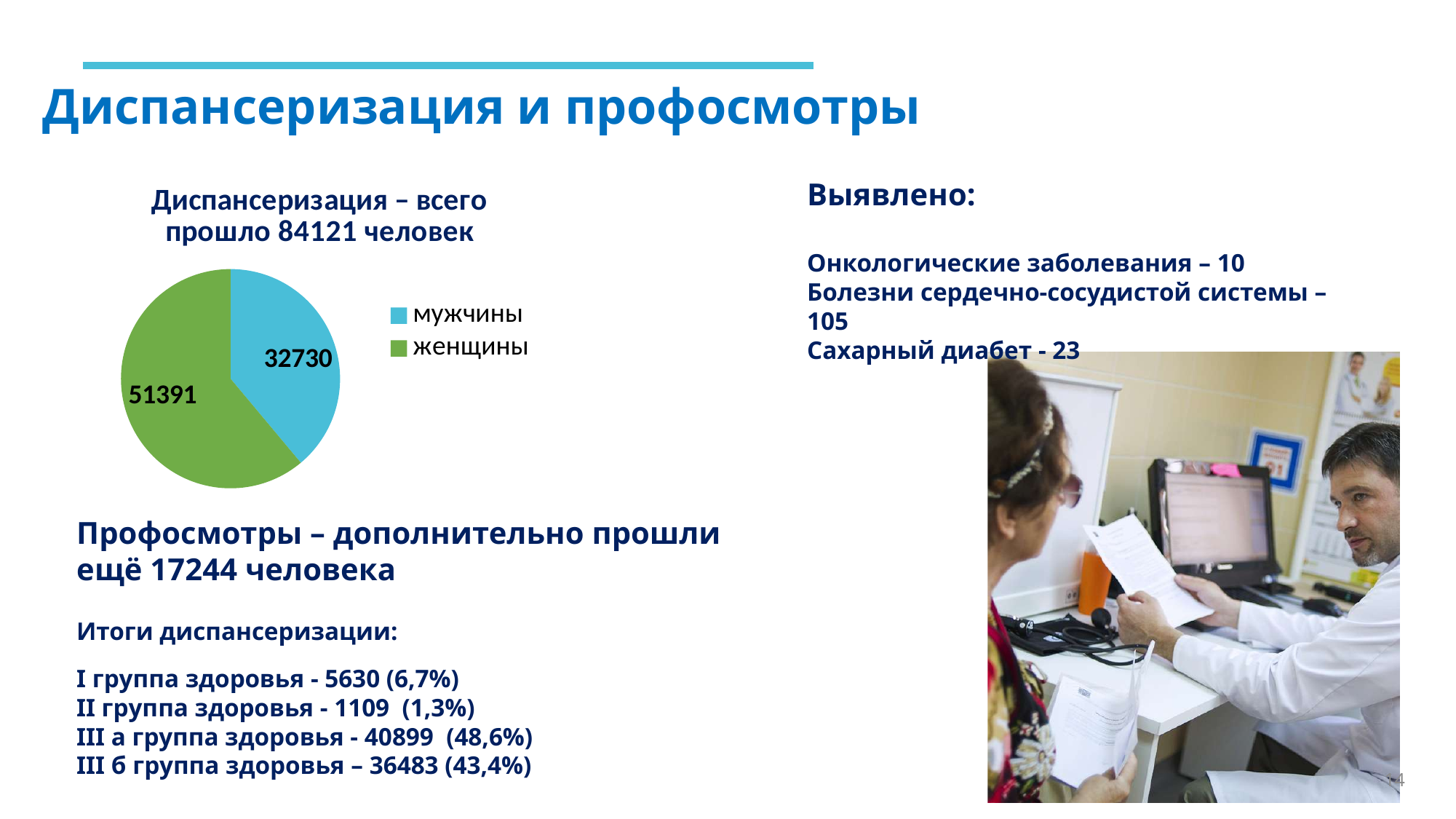
How many entries does the legend of the pie chart list? 2 What colour is the slice for женщины in the pie chart? green What is the value for мужчины in the pie chart? 32730 What is the total of the two slices in the pie chart? 84121 What is the difference between the values for женщины and мужчины in the pie chart? 18661 What is the title of the pie chart? Диспансеризация – всего прошло 84121 человек Which is larger in the pie chart, мужчины or женщины? женщины What kind of chart is shown on the slide? pie chart What is the value for женщины in the pie chart? 51391 How many slices does the pie chart have? 2 Which category has the smallest slice in the pie chart? мужчины Which category has the largest slice in the pie chart? женщины